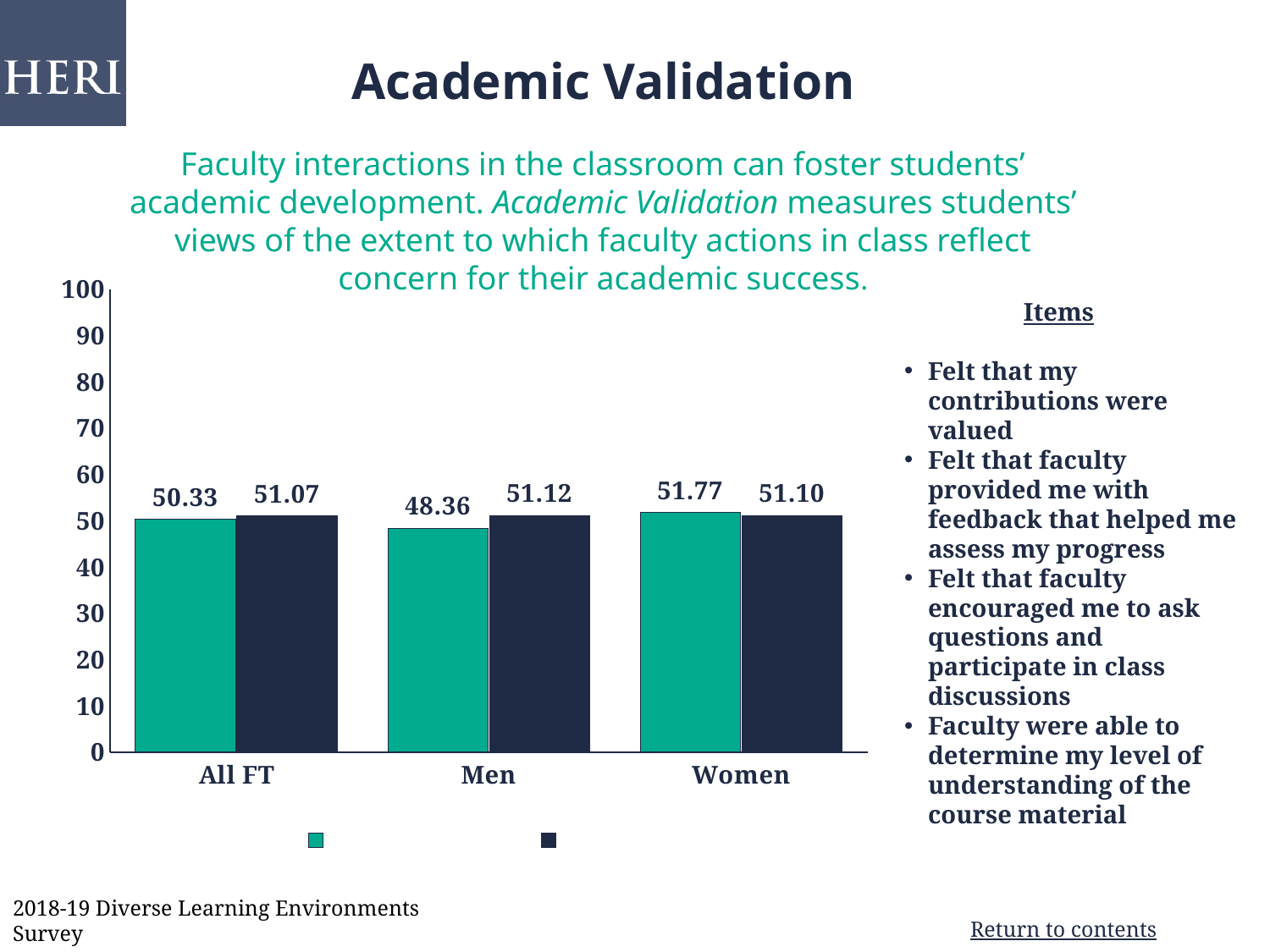
What kind of chart is shown on the slide? bar chart How many categories are shown on the x axis? 3 What is the value of the green bar for All FT? 50.33 What is the value of the green bar for Men? 48.36 What is the value of the dark navy bar for Women? 51.10 Among the green bars, which category has the highest value? Women For Women, what is the difference between the green bar and the dark navy bar? 0.67 Is the value of the green bar for Men greater or less than 50? less Among the green bars, which category has the lowest value? Men How many series does the legend show? 2 For Men, which bar is larger, the green bar or the dark navy bar? the dark navy bar For Men, how much larger is the dark navy bar than the green bar? 2.76